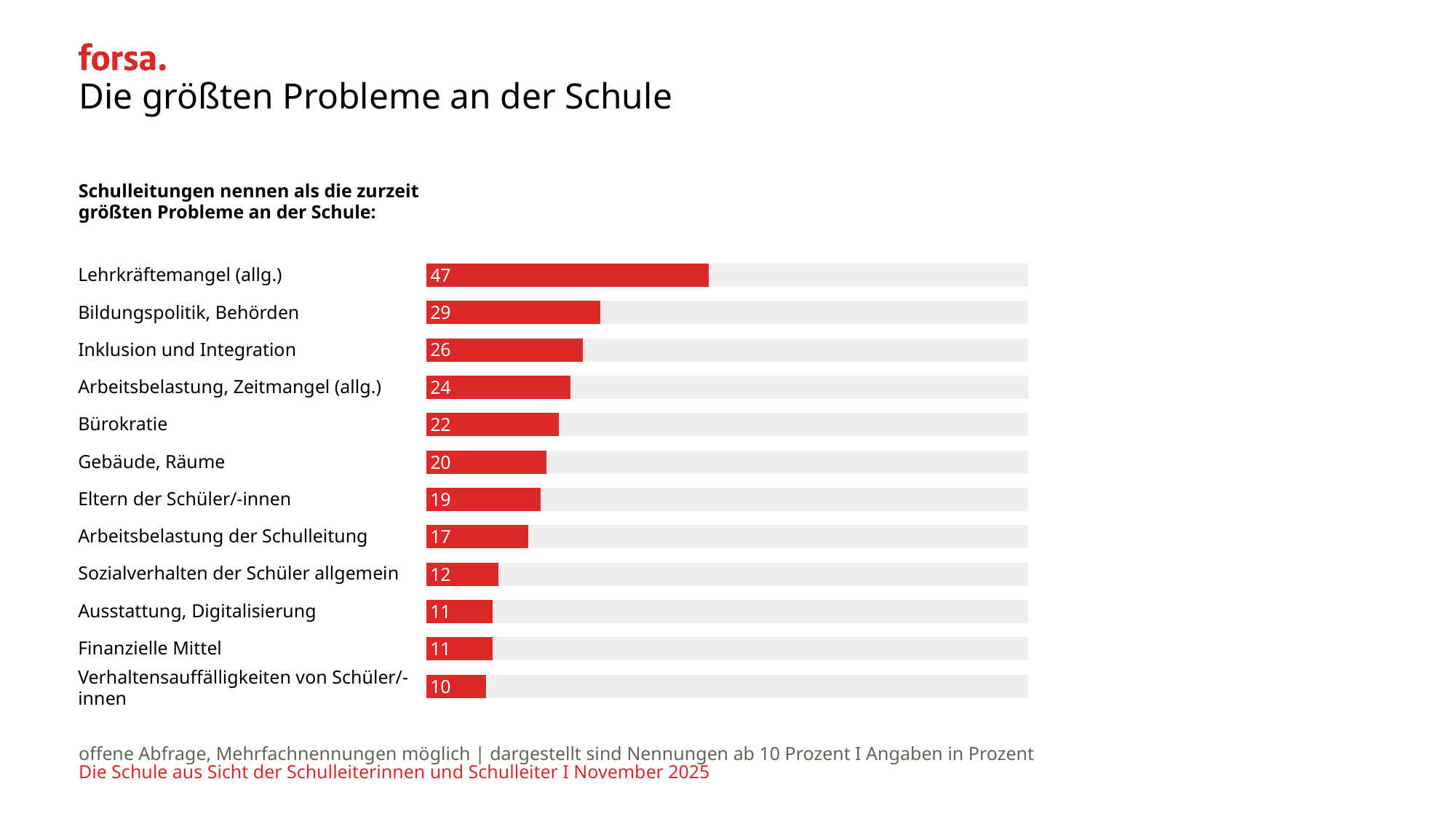
Which category has the lowest value? Verhaltensauffälligkeiten von Schüler/-innen What value is shown for Bürokratie? 22 Which category has the highest value? Lehrkräftemangel (allg.) What value is shown for Sozialverhalten der Schüler allgemein? 12 How many categories are shown in the chart? 12 What is the difference between the values for Gebäude, Räume and Arbeitsbelastung der Schulleitung? 3 What is the difference between the values for Lehrkräftemangel (allg.) and Bildungspolitik, Behörden? 18 What value is shown for Lehrkräftemangel (allg.)? 47 Which is larger, the value for Arbeitsbelastung, Zeitmangel (allg.) or the value for Eltern der Schüler/-innen? Arbeitsbelastung, Zeitmangel (allg.) What kind of chart is shown on the slide? Bar chart What is the title of the slide? Die größten Probleme an der Schule What value is shown for Inklusion und Integration? 26